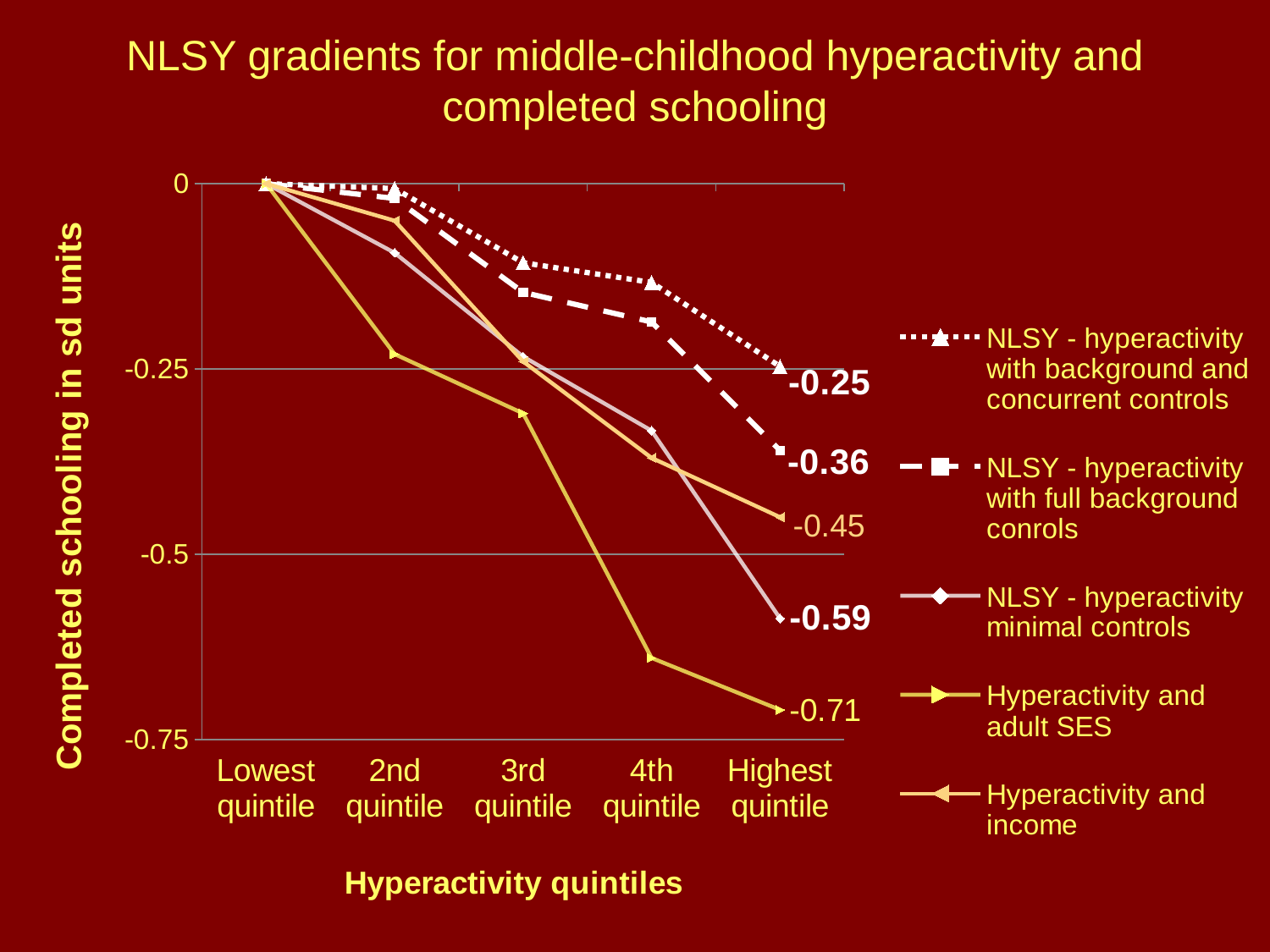
What is the value for the 'NLSY - hyperactivity with background and concurrent controls' series at the Highest quintile? -0.25 What is the value for the 'Hyperactivity and income' series at the Highest quintile? -0.45 What is the value for the 'Hyperactivity and adult SES' series at the Highest quintile? -0.71 How many hyperactivity quintile categories are shown on the x axis? 5 What is the value for the 'NLSY - hyperactivity with full background conrols' series at the Highest quintile? -0.36 How many series does the legend list? 5 What kind of chart is shown on the slide? Line chart Is the value for the 'Hyperactivity and adult SES' series at the 4th quintile greater or less than -0.5? less At the Highest quintile, which series has the higher value: 'Hyperactivity and income' or 'NLSY - hyperactivity minimal controls'? Hyperactivity and income What is the value for the 'NLSY - hyperactivity minimal controls' series at the Highest quintile? -0.59 Which series has the lowest value at the Highest quintile? Hyperactivity and adult SES What is the difference between the Highest quintile values of the 'NLSY - hyperactivity minimal controls' series (-0.59) and the 'NLSY - hyperactivity with background and concurrent controls' series (-0.25)? 0.34